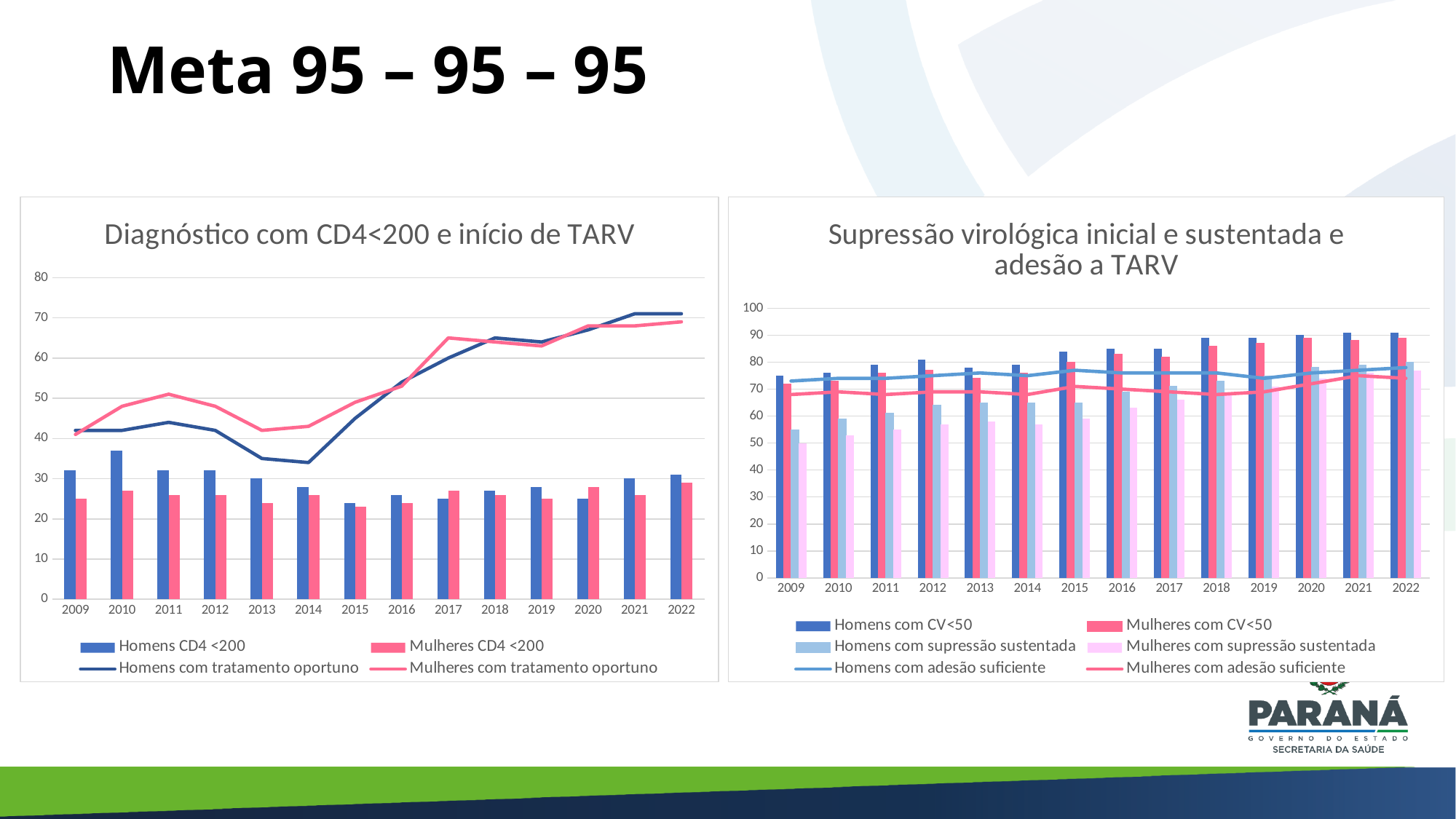
On the right chart 'Supressão virológica inicial e sustentada e adesão a TARV', how many series does the legend list? 6 On the left chart, in 2010, which is larger: 'Homens CD4 <200' or 'Mulheres CD4 <200'? Homens CD4 <200 On the left chart, is the value for 'Homens com tratamento oportuno' in 2014 greater or less than 40? less What is the title of the chart on the right side of the slide? Supressão virológica inicial e sustentada e adesão a TARV On the left chart, is the value for 'Mulheres com tratamento oportuno' in 2022 greater or less than 60? greater On the left chart 'Diagnóstico com CD4<200 e início de TARV', how many years are shown on the x axis? 14 On the right chart, in 2009, which is larger: 'Homens com CV<50' or 'Homens com supressão sustentada'? Homens com CV<50 On the right chart, is the value for 'Homens com CV<50' in 2022 greater or less than 80? greater On the left chart, in which year is the bar for 'Homens CD4 <200' highest? 2010 On the right chart, does the series 'Homens com CV<50' rise or fall from 2009 to 2022? rise On the left chart 'Diagnóstico com CD4<200 e início de TARV', how many series does the legend list? 4